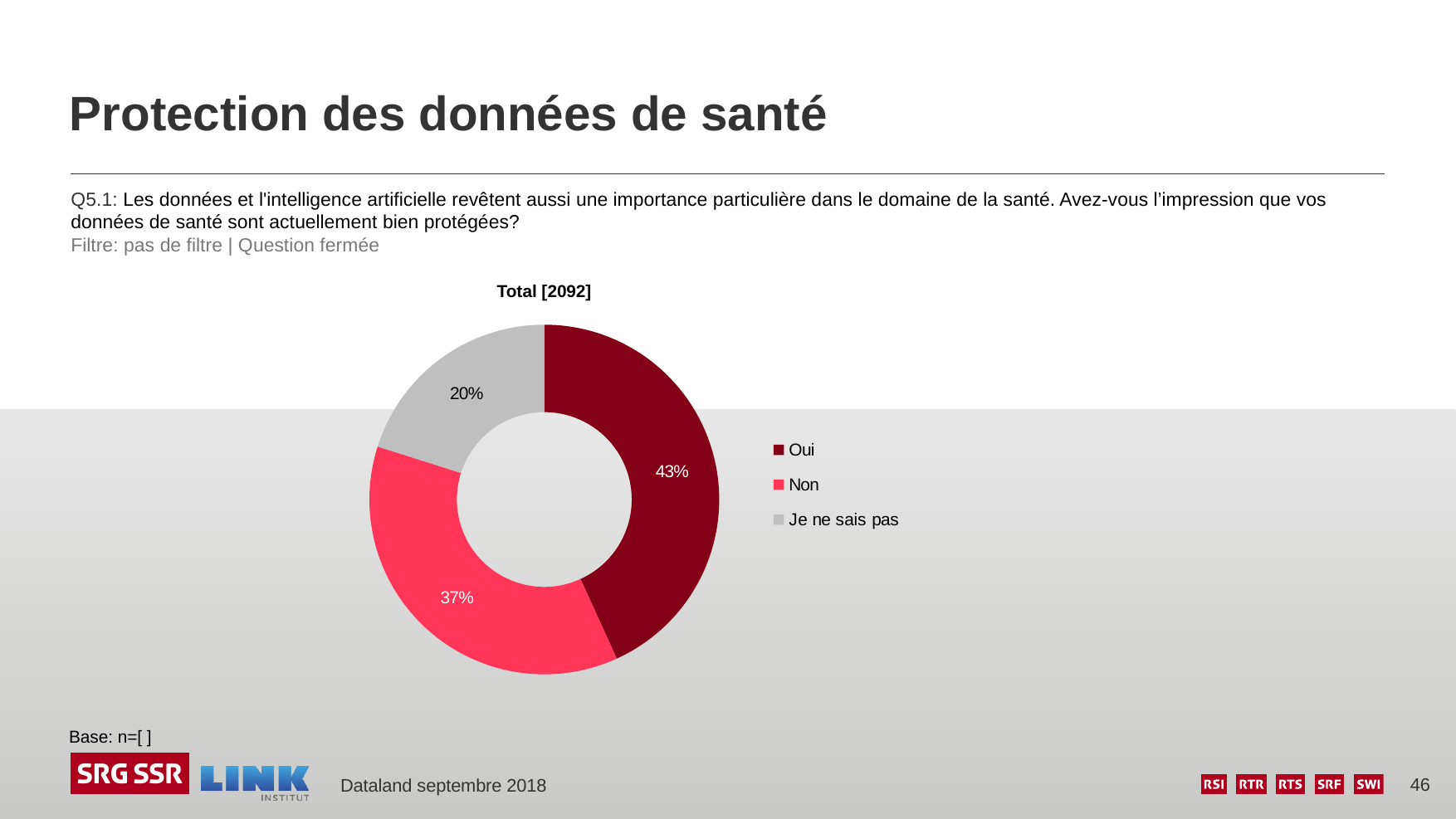
Which response has the largest share of the chart? Oui What percentage of respondents answered "Je ne sais pas"? 20% What is the title shown above the chart? Total [2092] How many response categories are shown in the chart? 3 What is the difference in percentage points between "Oui" and "Non"? 6 Which response has the smallest share of the chart? Je ne sais pas What percentage of respondents answered "Oui"? 43% What kind of chart is shown on the slide? Pie chart (doughnut) What is the difference in percentage points between "Non" and "Je ne sais pas"? 17 What percentage of respondents answered "Non"? 37% How many entries does the legend list? 3 Which is larger, the share for "Oui" or the share for "Non"? Oui